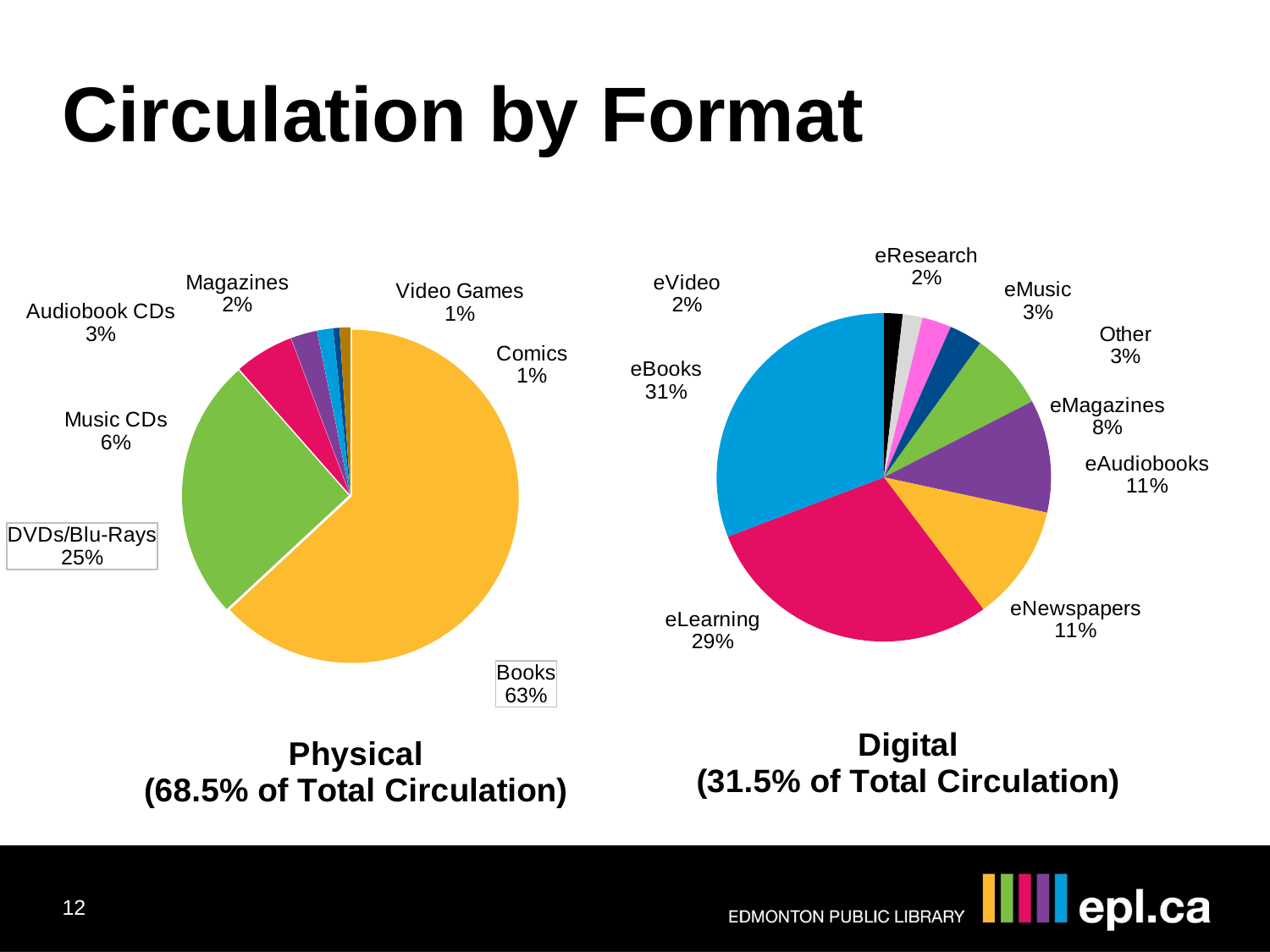
What kind of chart is used on this slide? Pie chart How many slices does the Physical pie chart have? 7 In the Physical pie chart, which format has the largest share? Books In the Digital pie chart, what share of circulation is eLearning? 29% In the Digital pie chart, which format has the largest share? eBooks In the Digital pie chart, which is larger, eMagazines or eMusic? eMagazines In the Physical pie chart, what share of circulation is DVDs/Blu-Rays? 25% How many slices does the Digital pie chart have? 9 In the Digital pie chart, what share of circulation is eBooks? 31% In the Physical pie chart, what is the difference between the Books share and the DVDs/Blu-Rays share? 38% According to the chart captions, what percentage of total circulation is Digital? 31.5%